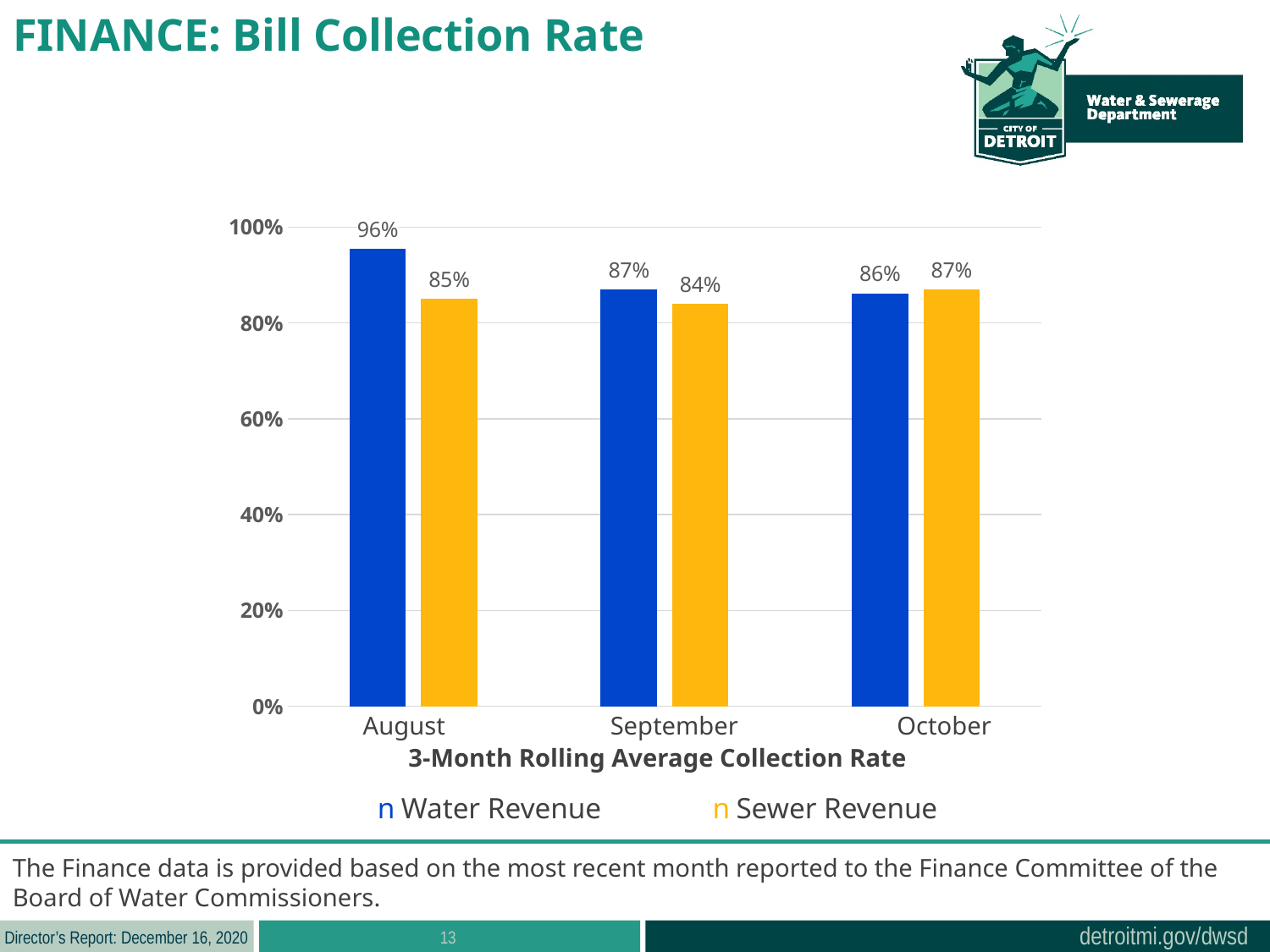
Is the Water Revenue collection rate for September greater or less than 80%? greater What kind of chart is shown on the slide? Bar chart In October, which is larger: the Water Revenue or the Sewer Revenue collection rate? Sewer Revenue How many months are shown on the x axis? 3 Which month has the highest Water Revenue collection rate? August What is the Sewer Revenue collection rate for September? 84% What is the Water Revenue collection rate for August? 96% How many series does the legend list? 2 What is the difference between the Water Revenue and Sewer Revenue collection rates in August? 11% Which month has the lowest Sewer Revenue collection rate? September What is the Sewer Revenue collection rate for October? 87% Does the Water Revenue collection rate rise or fall from August to September? Fall